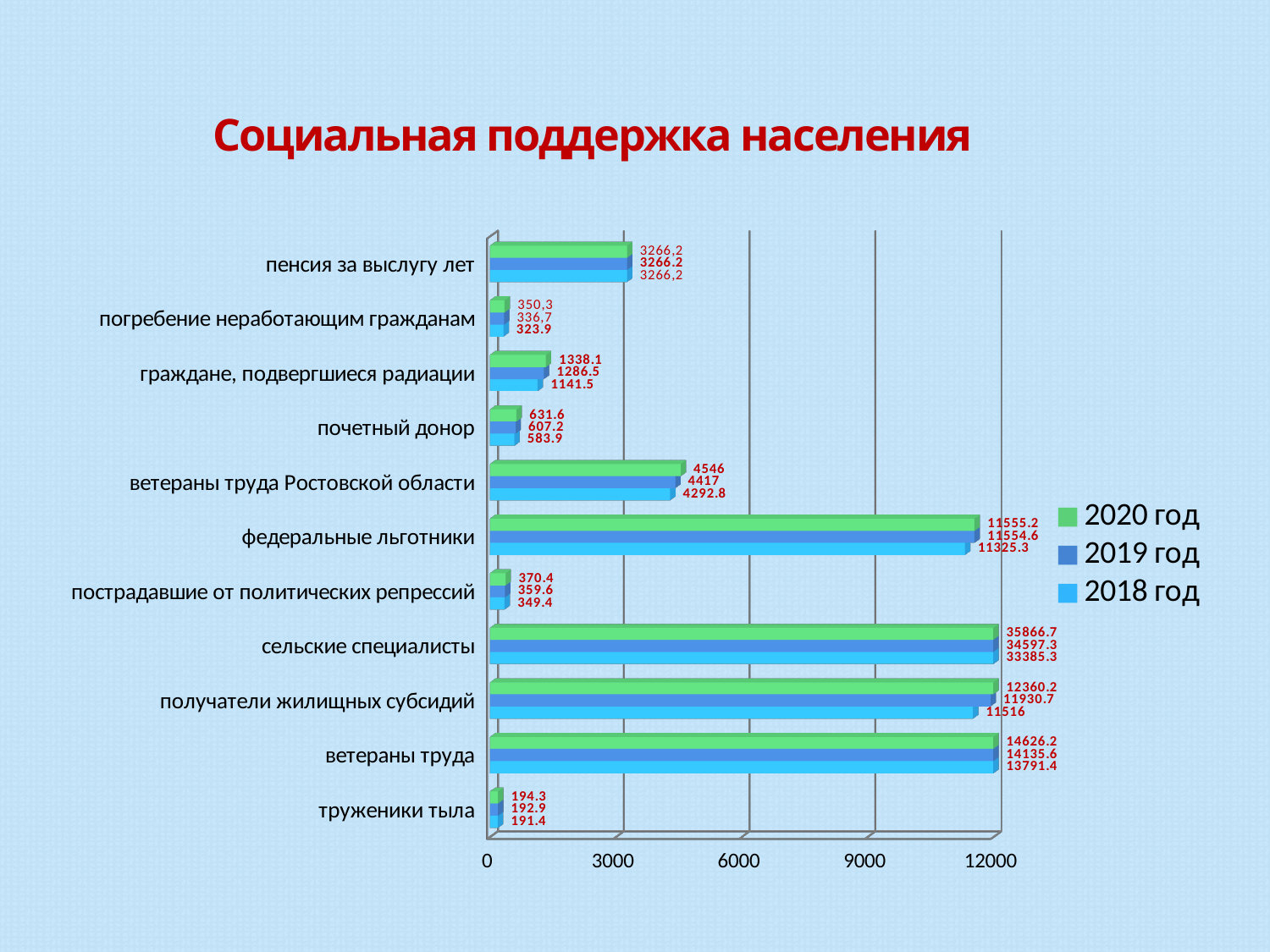
What is the value for сельские специалисты in 2020 год? 35866.7 What is the value for получатели жилищных субсидий in 2019 год? 11930.7 What is the title of the chart on the slide? Социальная поддержка населения Is the 2018 год value for федеральные льготники greater or less than 9000? greater How many series does the legend list? 3 Which category has the highest value for 2020 год? сельские специалисты What is the value for почетный донор in 2018 год? 583.9 How many categories are shown on the chart? 11 Which category has the lowest value for 2020 год? труженики тыла What type of chart is shown on the slide? bar chart What is the difference between the 2020 год and 2018 год values for ветераны труда? 834.8 Which is larger for 2020 год: ветераны труда Ростовской области or граждане, подвергшиеся радиации? ветераны труда Ростовской области